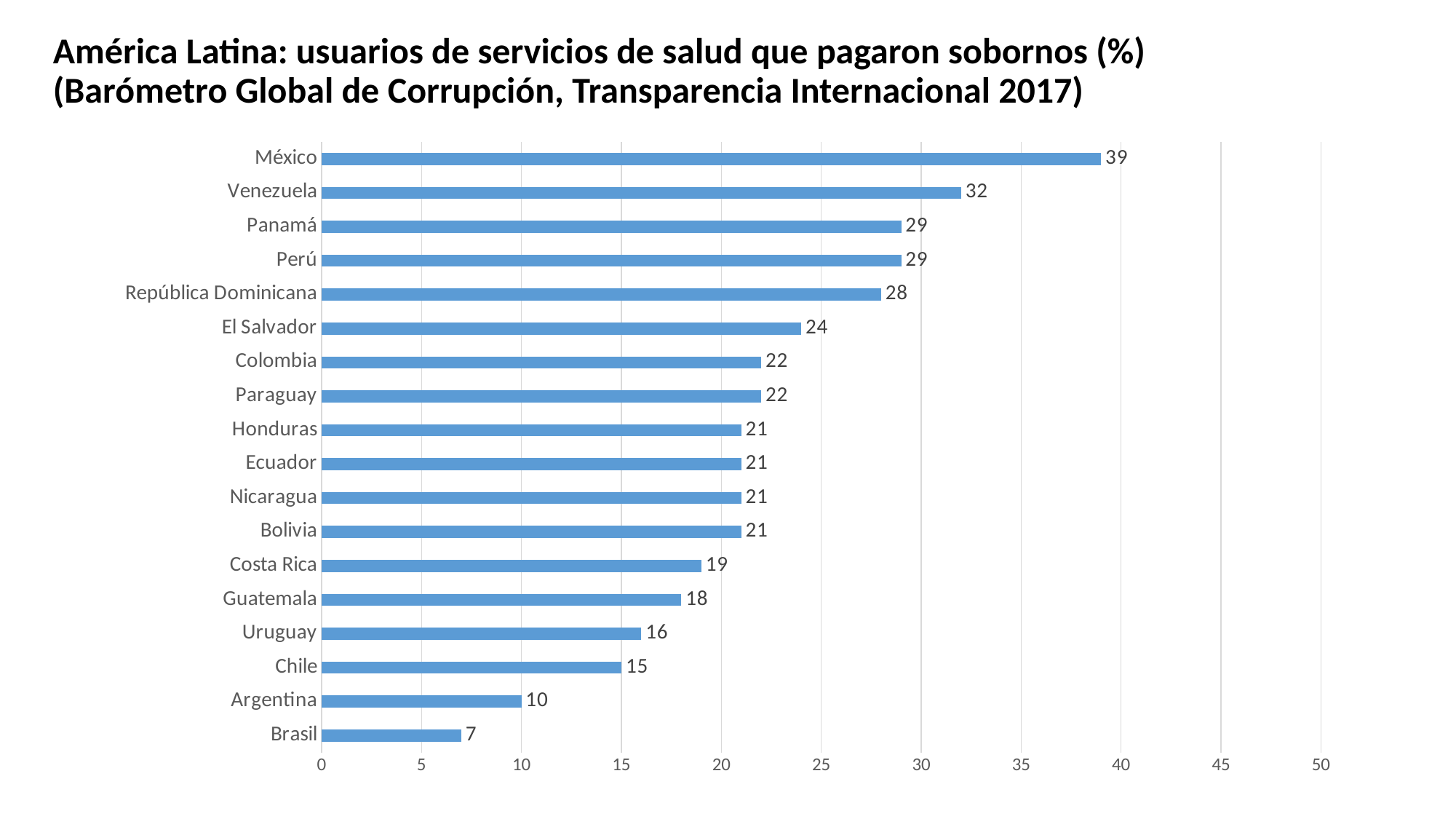
How many countries are shown in the chart? 18 Which is larger, the value for El Salvador or the value for Guatemala? El Salvador What kind of chart is shown on the slide? bar chart What is the value for México? 39 What is the value for República Dominicana? 28 What is the difference between the values for México and Venezuela? 7 Which country has the highest value? México What is the difference between the values for Argentina and Brasil? 3 Which country has the lowest value? Brasil Is the value for Uruguay greater or less than 20? less What is the highest value shown on the horizontal axis? 50 What is the value for Costa Rica? 19